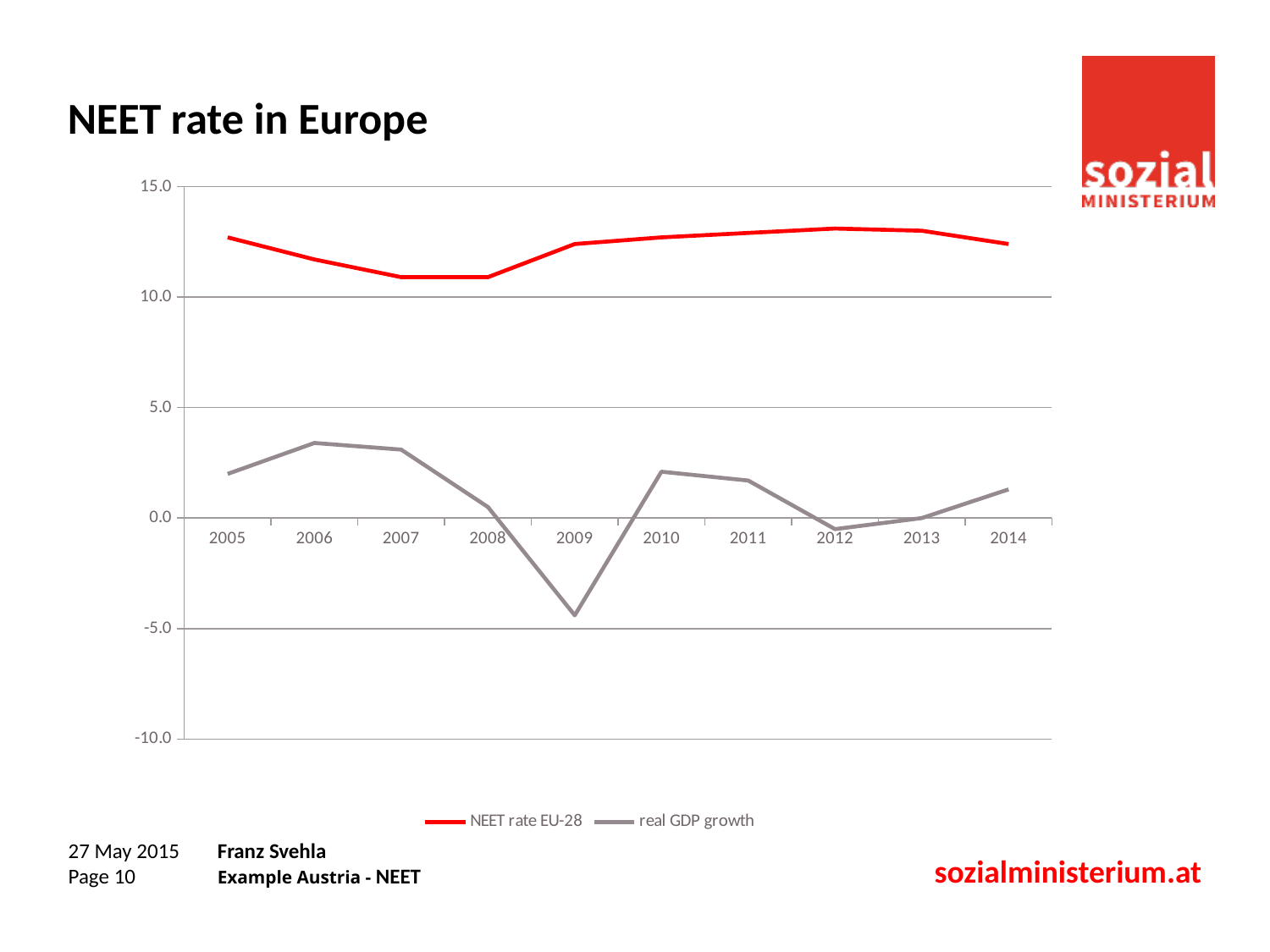
What is the title of the chart? NEET rate in Europe Does the NEET rate EU-28 rise or fall from 2005 to 2007? fall Is the value for real GDP growth in 2006 greater or less than 5.0? less In which year is real GDP growth lowest? 2009 What kind of chart is shown on the slide? line chart Is the value for real GDP growth in 2009 greater or less than 0.0? less Which is larger, the NEET rate EU-28 in 2005 or in 2007? 2005 How many years are plotted along the x axis? 10 How many series does the legend list? 2 Is the value for real GDP growth in 2009 greater or less than -5.0? greater Which is larger, real GDP growth in 2006 or in 2008? 2006